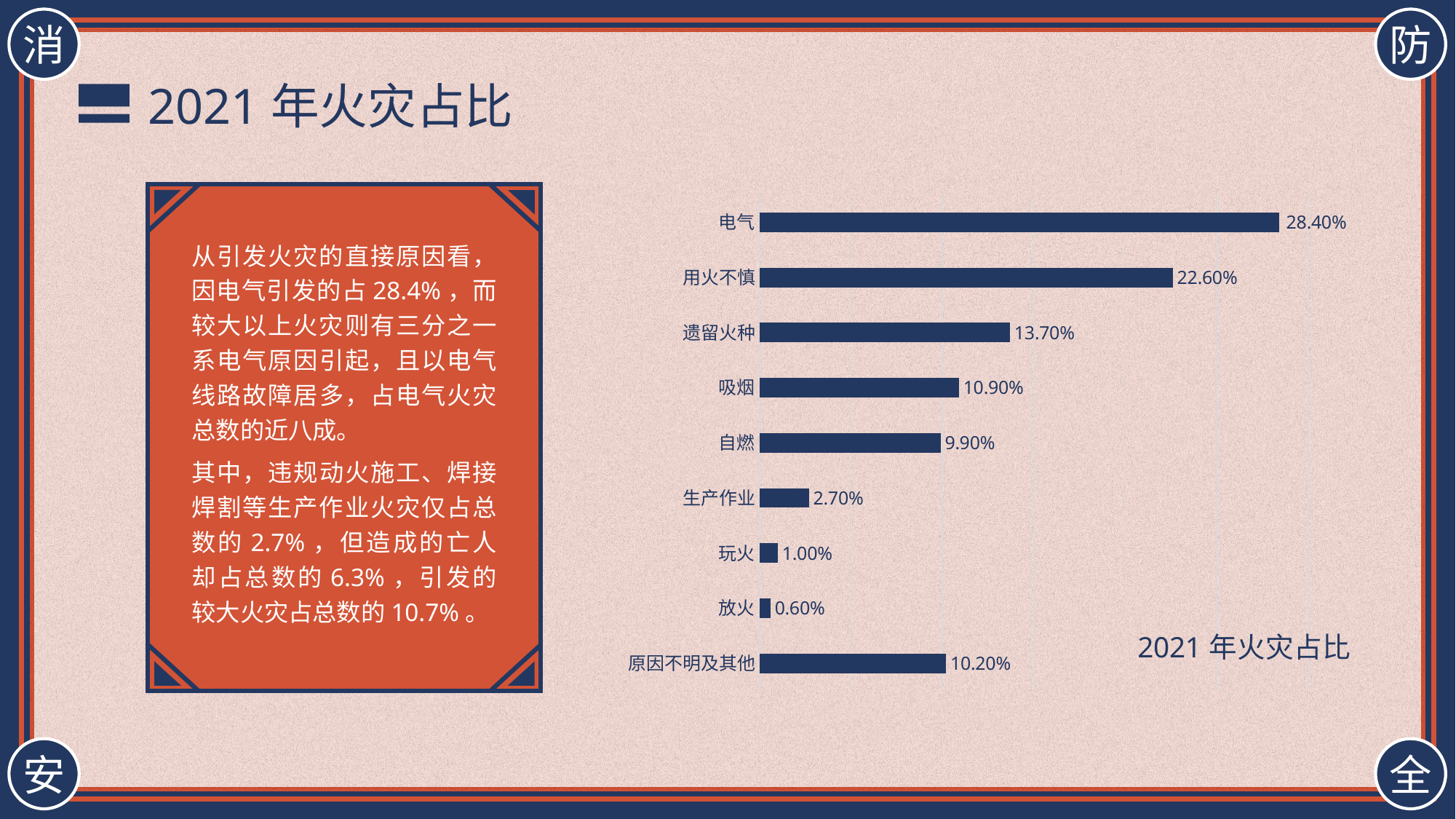
What kind of chart is shown on the slide? bar chart What is the value for 吸烟? 10.90% What is the value for 电气? 28.40% How many categories are shown in the chart? 9 What is the difference between the values for 遗留火种 and 吸烟? 2.80% What is the value for 原因不明及其他? 10.20% Which is larger, the value for 自燃 or the value for 原因不明及其他? 原因不明及其他 What is the difference between the values for 电气 and 用火不慎? 5.80% What is the value for 用火不慎? 22.60% Which category has the lowest value? 放火 Which category has the highest value? 电气 What is the title of the chart? 2021 年火灾占比